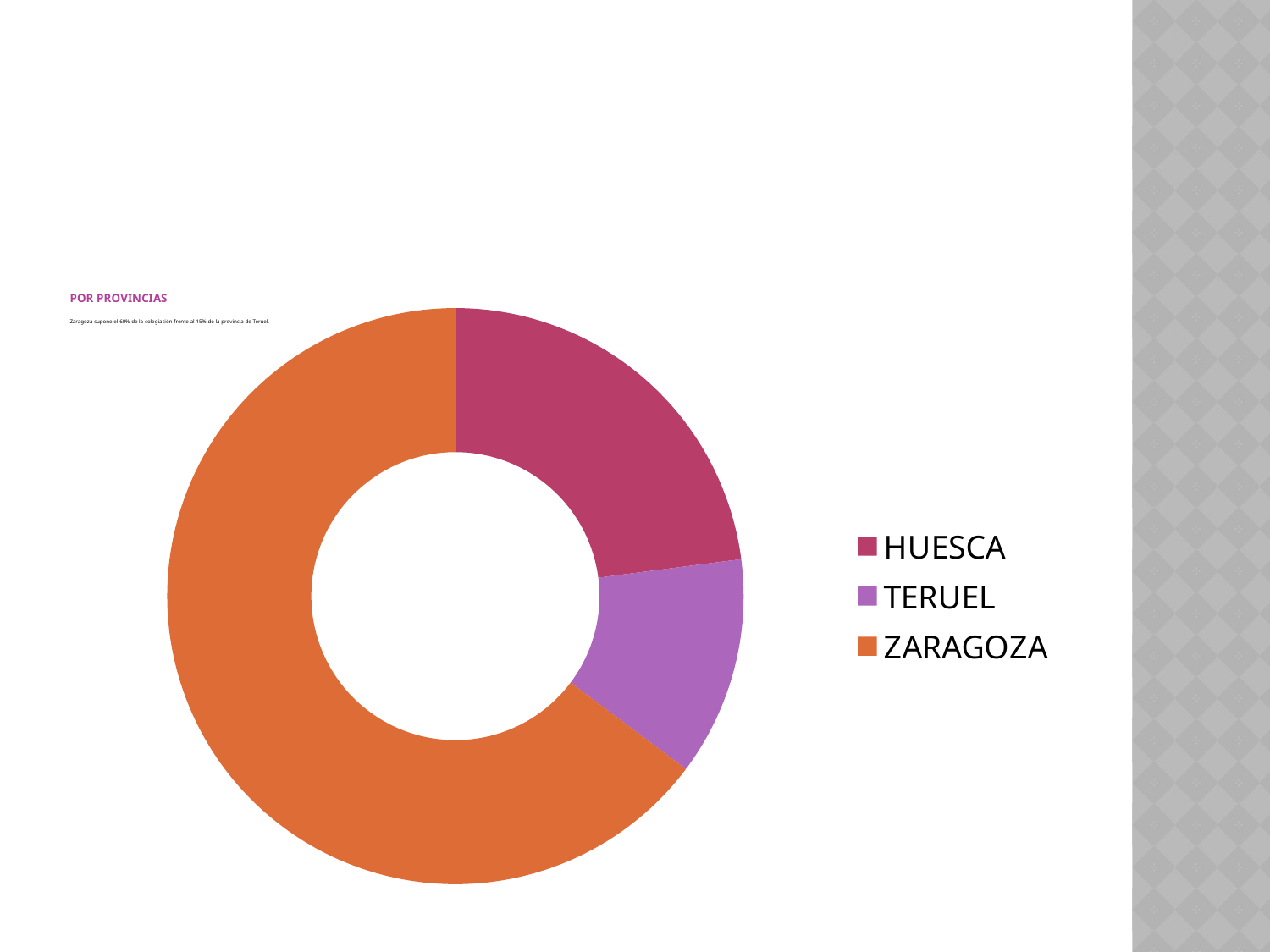
What kind of chart is shown on the slide? doughnut chart Which province has the smallest share of the chart? TERUEL Does ZARAGOZA account for more or less than half of the chart? more Which is larger, the share for HUESCA or the share for TERUEL? HUESCA How many entries does the legend list? 3 What is the title of the chart? POR PROVINCIAS How many categories does the chart show? 3 What colour represents ZARAGOZA in the chart? orange Which province has the largest share of the chart? ZARAGOZA Which is larger, the share for ZARAGOZA or the share for HUESCA? ZARAGOZA